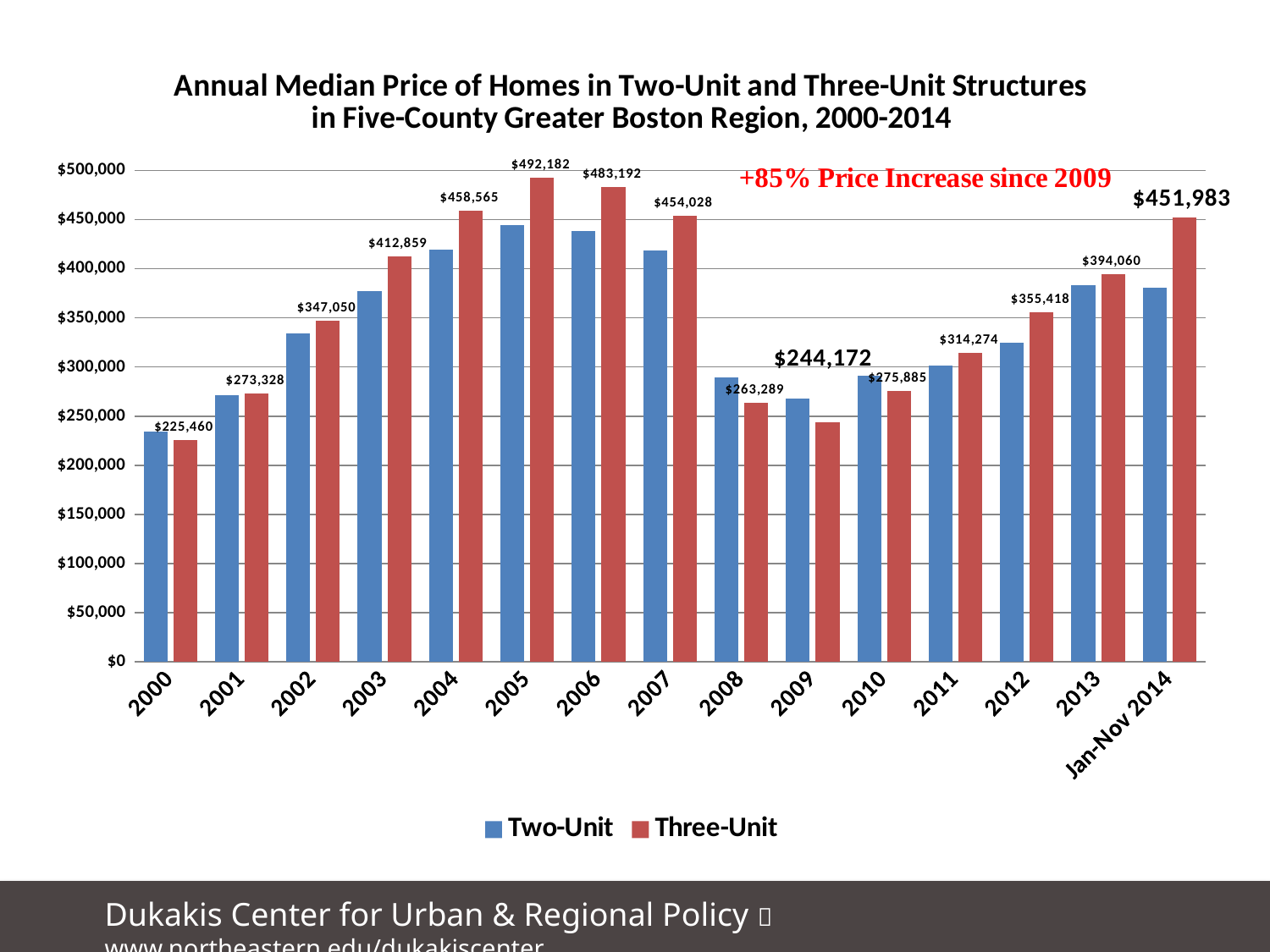
In which year is the Three-Unit median price highest? 2005 What is the difference between the Three-Unit median price in 2005 and in 2009? $248,010 What is the difference between the Three-Unit median price in Jan-Nov 2014 and in 2013? $57,923 What is the Three-Unit median price for Jan-Nov 2014? $451,983 What kind of chart is shown on the slide? bar chart Is the Two-Unit median price for 2000 greater or less than $250,000? less What is the Three-Unit median price for 2005? $492,182 In which year is the Three-Unit median price lowest? 2009 How many series does the legend list? 2 Do the Three-Unit median prices rise or fall from 2009 to Jan-Nov 2014? rise Which year has the higher Three-Unit median price, 2004 or 2007? 2004 How many time periods are shown on the x axis? 15